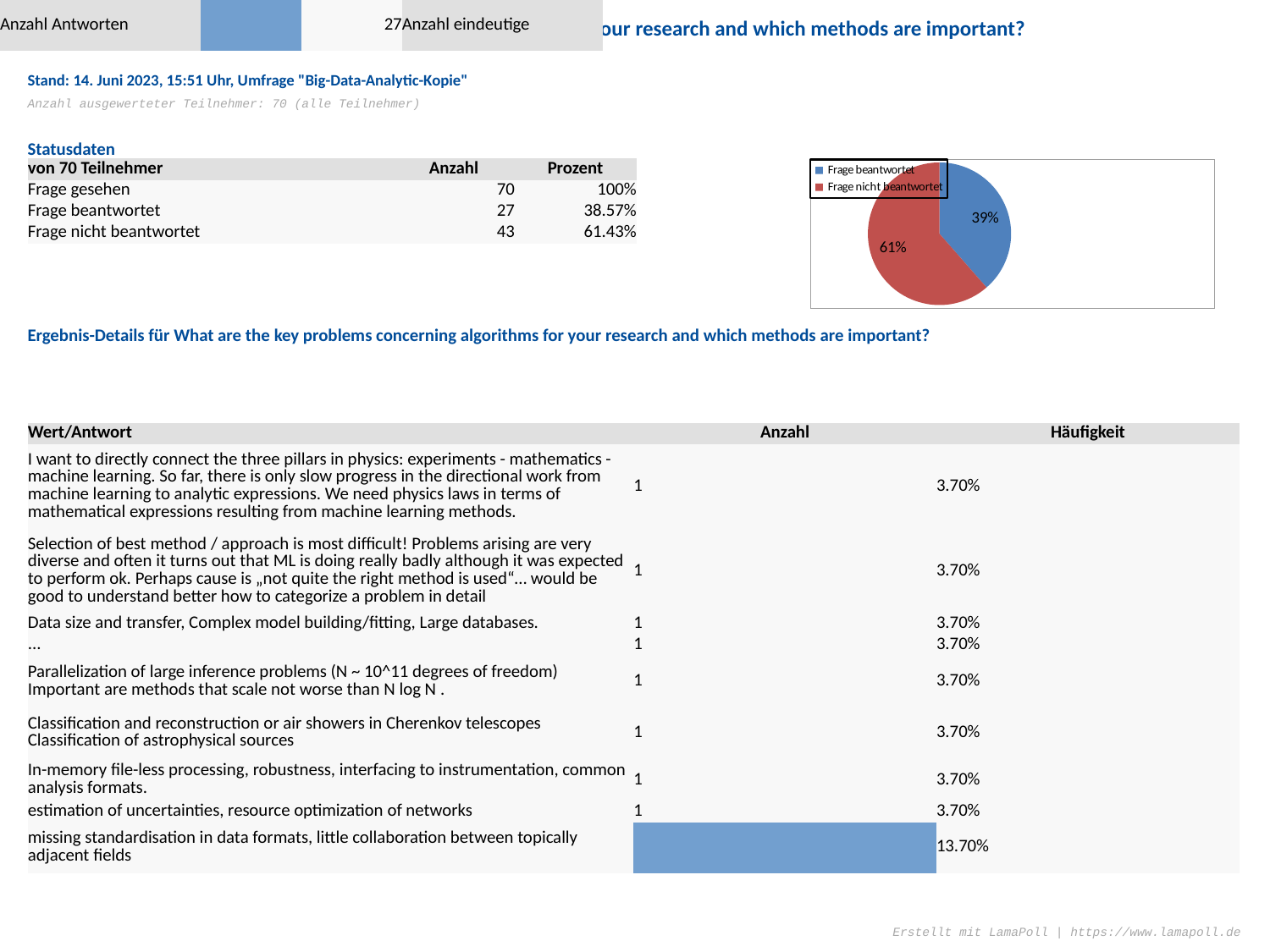
How many slices does the pie chart have? 2 Which slice of the pie chart is the largest? Frage nicht beantwortet How many entries does the legend of the pie chart list? 2 Is the share for "Frage beantwortet" in the pie chart greater or less than 50%? less What colour is the "Frage beantwortet" slice in the pie chart? blue What kind of chart is shown on the right side of the slide next to the Statusdaten table? pie chart In the pie chart, what share is shown for "Frage nicht beantwortet"? 61% What is the difference in percentage points between the two slices of the pie chart? 22% In the pie chart, what share is shown for "Frage beantwortet"? 39% What colour is the "Frage nicht beantwortet" slice in the pie chart? red Which slice of the pie chart is the smallest? Frage beantwortet In the pie chart, which is larger: "Frage beantwortet" or "Frage nicht beantwortet"? Frage nicht beantwortet